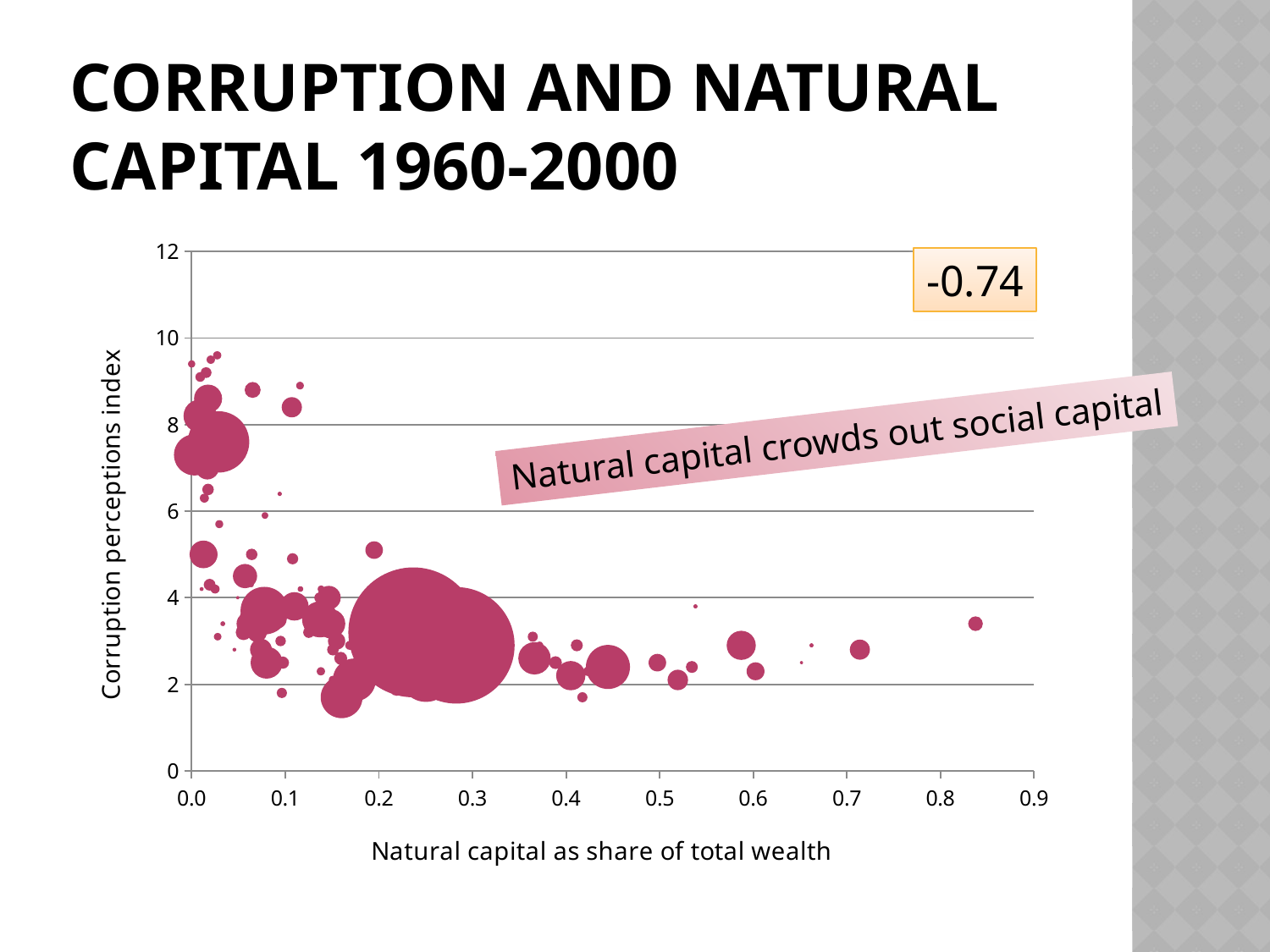
What does the annotation across the chart say? Natural capital crowds out social capital Is the corruption perceptions index of the largest bubble greater or less than 4? less What is the title of the chart on the slide? CORRUPTION AND NATURAL CAPITAL 1960-2000 What kind of chart is shown on the slide? Bubble chart What is the label of the vertical axis? Corruption perceptions index Does the corruption perceptions index generally rise or fall as natural capital share increases along the x axis? Fall What is the highest value shown on the vertical axis? 12 Is the corruption perceptions index of the bubble furthest to the right (near 0.84) greater or less than 6? less What correlation value is shown in the box at the top right of the chart? -0.74 What is the label of the horizontal axis? Natural capital as share of total wealth Is the natural capital share of the largest bubble greater or less than 0.2? greater What is the highest value shown on the horizontal axis? 0.9